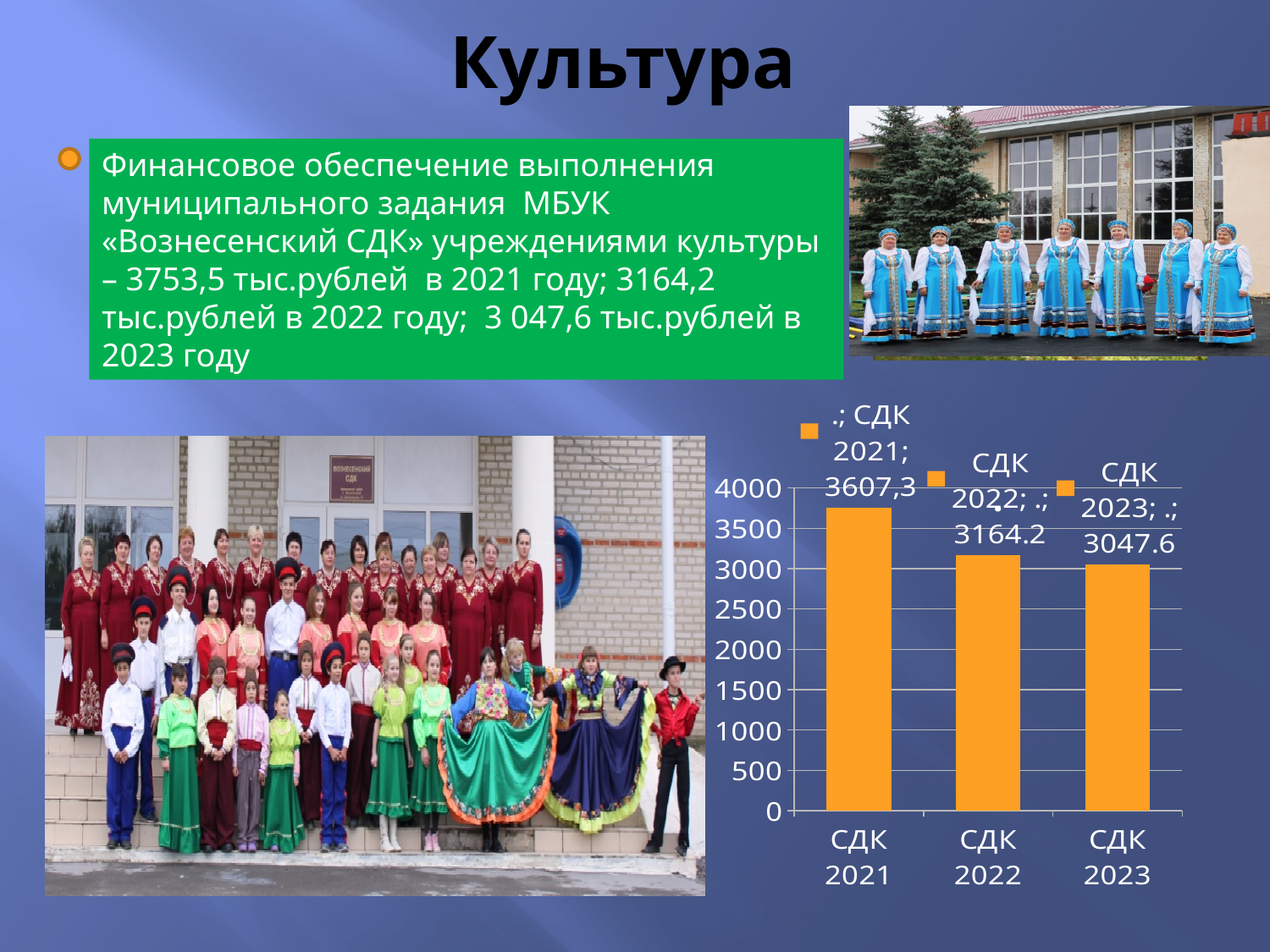
What colour are the bars in the chart? orange Is the value for СДК 2021 greater or less than 3500? greater Is the value for СДК 2023 greater or less than 3500? less How many bars does the chart have? 3 What is the value for СДК 2022? 3164.2 Which category has the highest bar? СДК 2021 Which category has the lowest bar? СДК 2023 What kind of chart is shown on the slide? bar chart What is the difference between the values for СДК 2022 and СДК 2023? 116.6 Do the values rise or fall from СДК 2021 to СДК 2023? fall Which is larger, the value for СДК 2022 or СДК 2023? СДК 2022 What is the value for СДК 2023? 3047.6